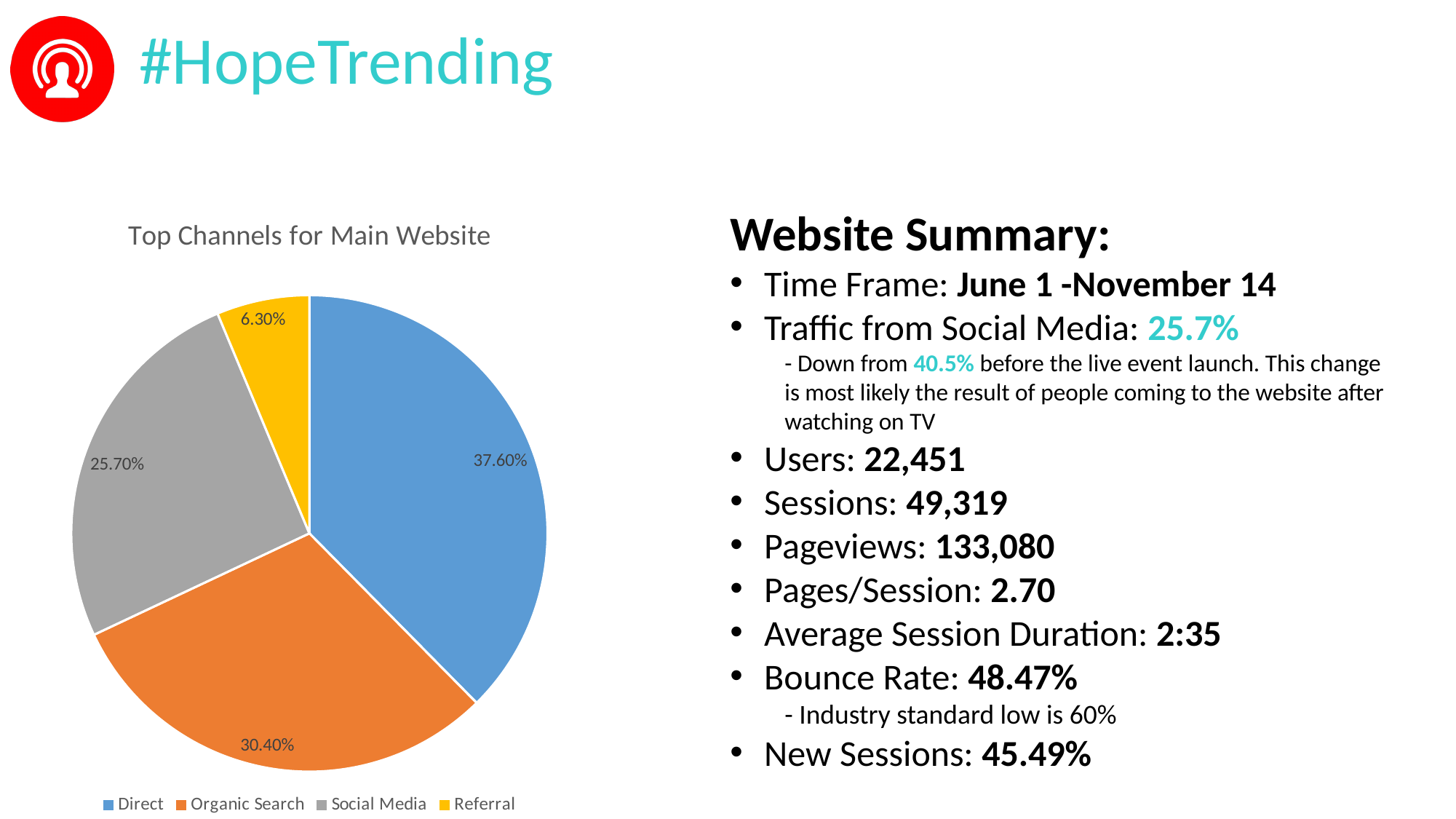
What is the difference between the Direct and Organic Search shares? 7.20% What is the value shown for Organic Search? 30.40% Which is larger, the Social Media slice or the Referral slice? Social Media What is the title of the chart? Top Channels for Main Website What is the value shown for Social Media? 25.70% Which colour represents Organic Search in the legend? orange Which channel has the largest slice of the pie? Direct What type of chart is shown on the slide? pie chart How many channels are shown in the pie chart? 4 Which channel has the smallest slice of the pie? Referral What share of the pie does Direct account for? 37.60% What is the value shown for Referral? 6.30%